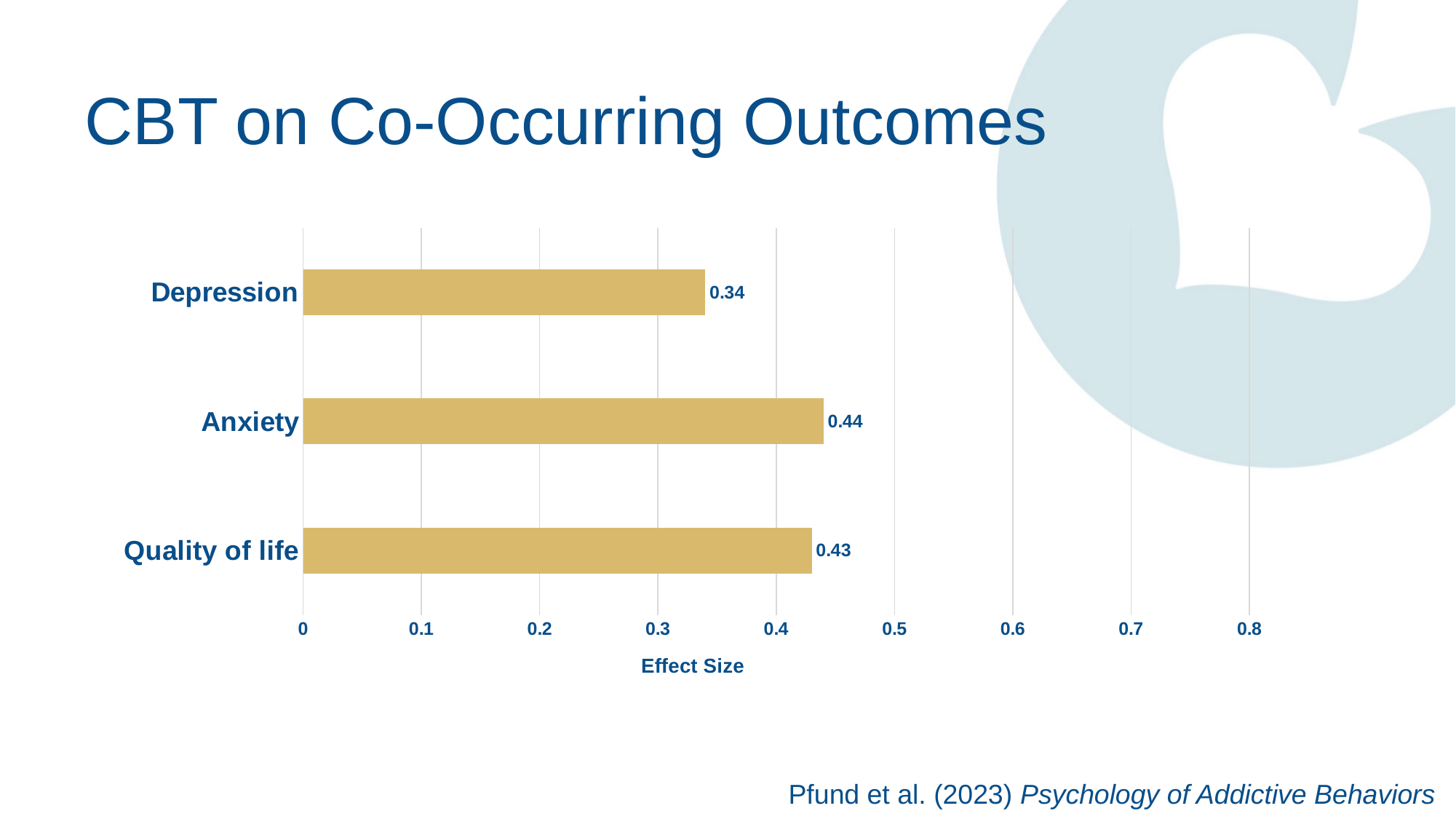
What is the difference between the effect sizes for Anxiety and Depression? 0.10 Which outcome has the largest effect size? Anxiety How many outcomes are shown in the chart? 3 What is the label of the horizontal axis? Effect Size What is the difference between the effect sizes for Quality of life and Depression? 0.09 What is the effect size for Quality of life? 0.43 Which has a larger effect size, Depression or Quality of life? Quality of life What is the effect size for Depression? 0.34 What kind of chart is shown on the slide? Bar chart What is the effect size for Anxiety? 0.44 Is the effect size for Depression greater or less than 0.4? less Which outcome has the smallest effect size? Depression